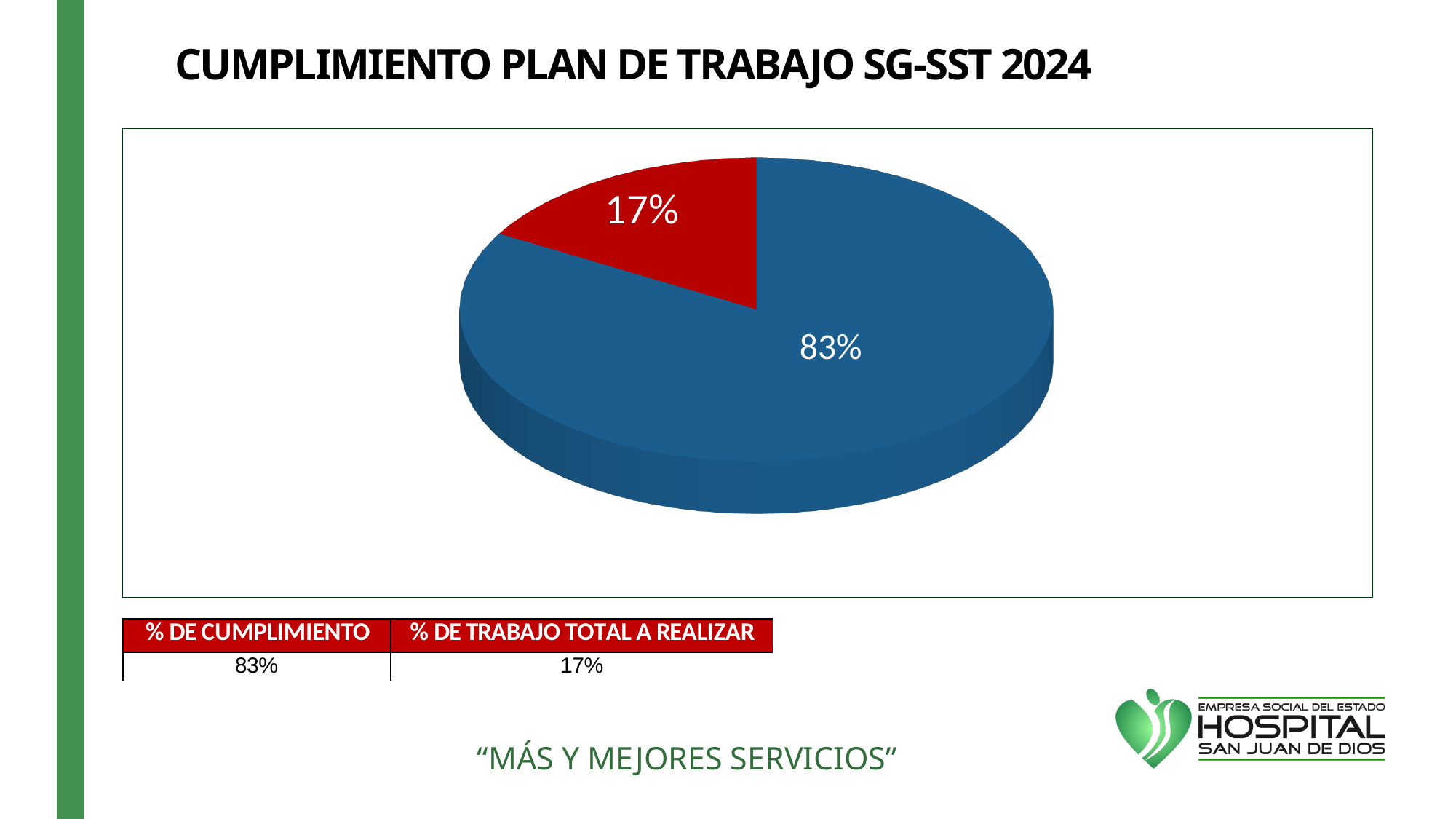
According to the table below the chart, what is the value for % DE TRABAJO TOTAL A REALIZAR? 17% Which slice of the pie chart is the largest? 83% How many slices does the pie chart have? 2 Which slice of the pie chart is the smallest? 17% Which is larger, the blue slice or the red slice? The blue slice According to the table below the chart, what is the value for % DE CUMPLIMIENTO? 83% What kind of chart is shown on the slide? Pie chart What percentage is shown on the blue slice of the pie chart? 83% What percentage is shown on the red slice of the pie chart? 17% What colour is the slice representing 17%? Red What is the difference between the two slice values in the pie chart? 66% What is the title of the slide containing the pie chart? CUMPLIMIENTO PLAN DE TRABAJO SG-SST 2024